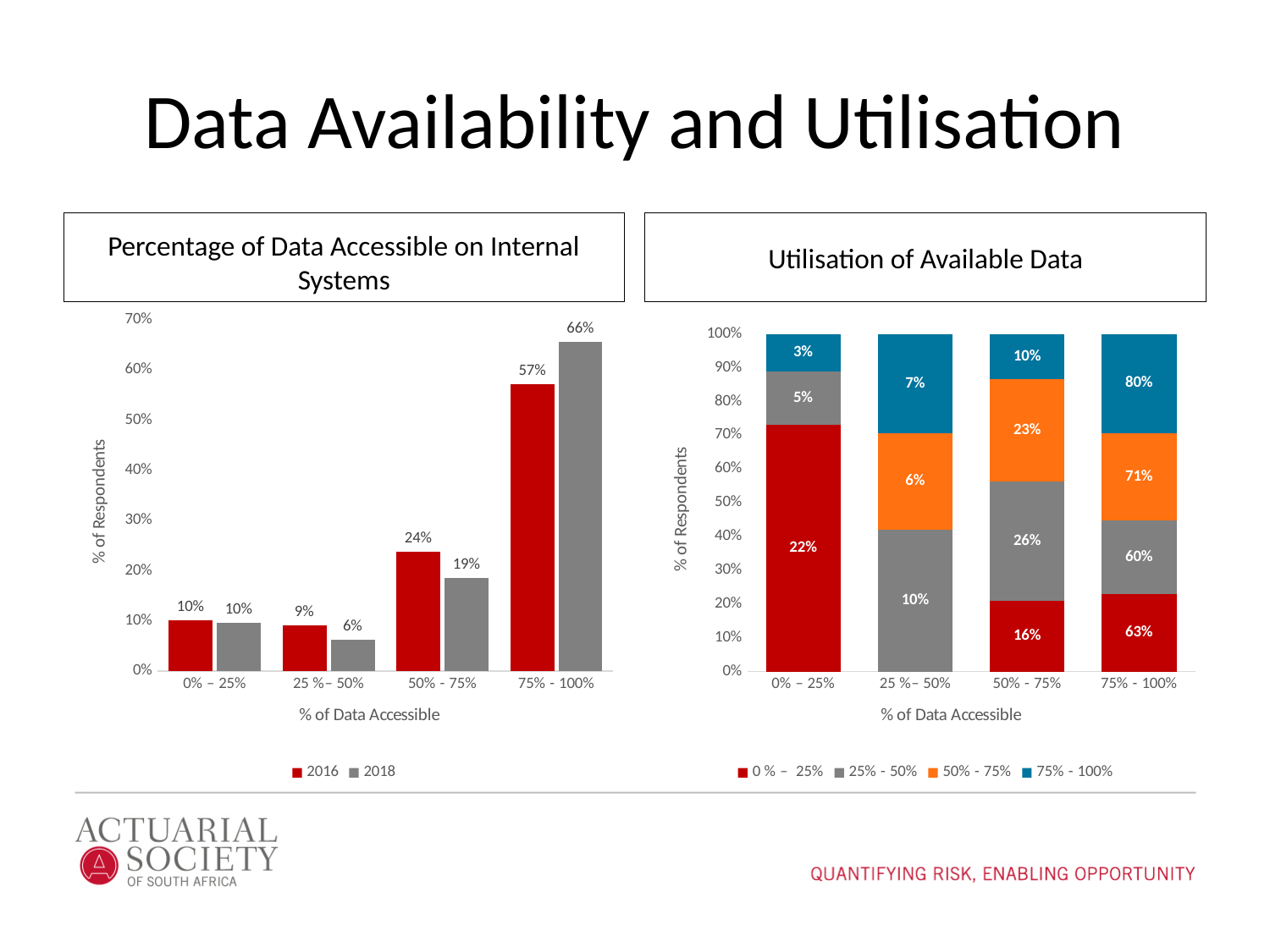
On the 'Utilisation of Available Data' chart, what is the label on the 0% - 25% segment of the 50% - 75% bar? 16% On the 'Percentage of Data Accessible on Internal Systems' chart, what is the 2018 value for the 75% - 100% category? 66% How many series does the legend of the 'Utilisation of Available Data' chart list? 4 How many series does the legend of the 'Percentage of Data Accessible on Internal Systems' chart list? 2 How many categories are shown on the x axis of the 'Utilisation of Available Data' chart? 4 On the 'Utilisation of Available Data' chart, what is the label on the 75% - 100% segment of the 75% - 100% bar? 80% On the 'Percentage of Data Accessible on Internal Systems' chart, which category has the highest 2016 value? 75% - 100% What kind of chart is 'Utilisation of Available Data'? Stacked bar chart On the 'Percentage of Data Accessible on Internal Systems' chart, is the 2016 or the 2018 value larger for the 50% - 75% category? 2016 On the 'Percentage of Data Accessible on Internal Systems' chart, which category has the lowest 2018 value? 25 %– 50% On the 'Percentage of Data Accessible on Internal Systems' chart, what is the difference between the 2018 and 2016 values for the 75% - 100% category? 9% On the 'Percentage of Data Accessible on Internal Systems' chart, what is the 2016 value for the 50% - 75% category? 24%